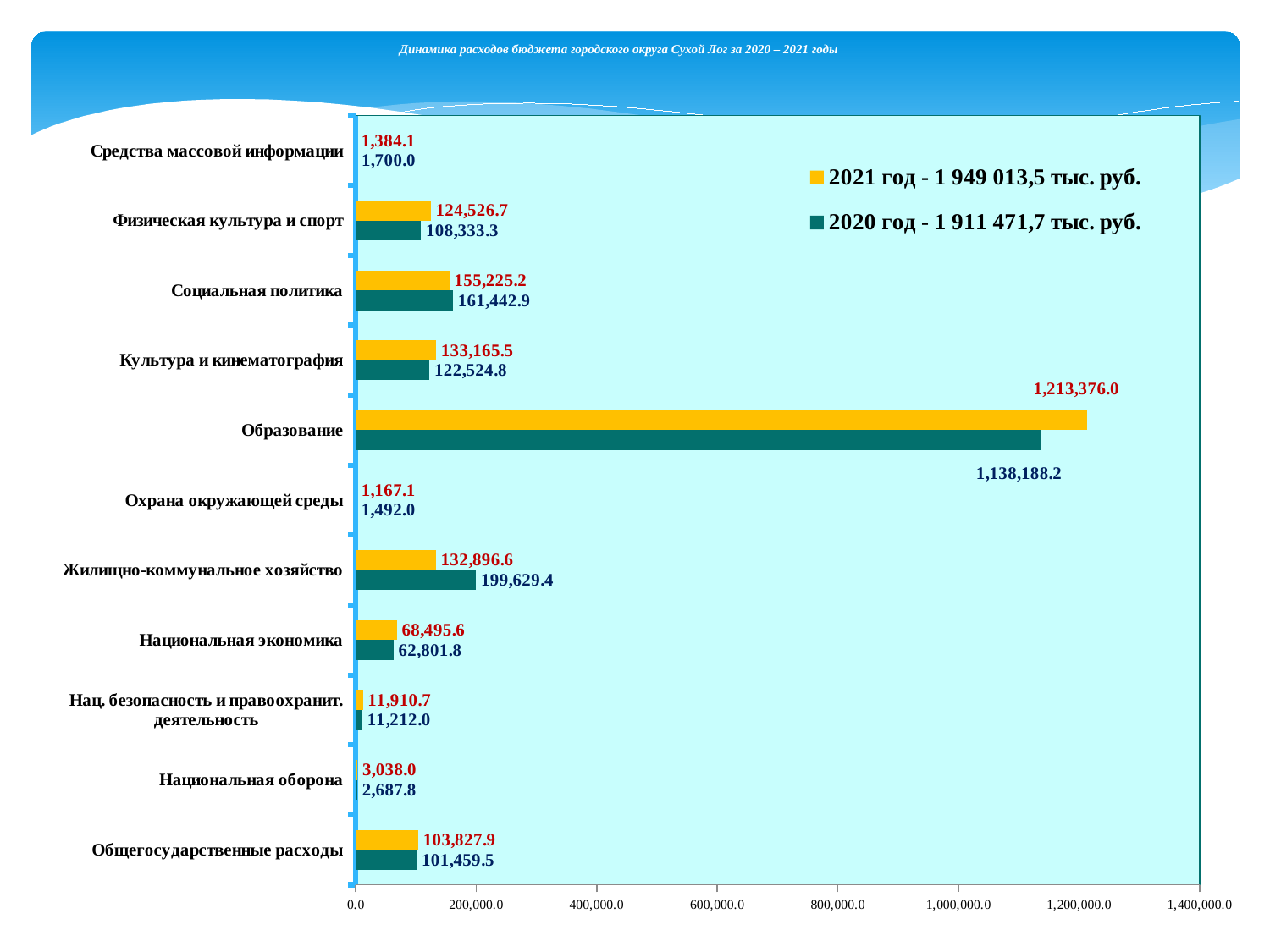
What is the 2020 value for Жилищно-коммунальное хозяйство? 199,629.4 How many expenditure categories are shown on the chart? 11 Which category has the lowest 2021 value? Охрана окружающей среды What is the difference between the 2021 and 2020 values for Образование? 75,187.8 Is the 2020 value for Образование greater or less than 1,000,000.0? greater For Жилищно-коммунальное хозяйство, which year has the larger value, 2020 or 2021? 2020 What is the 2021 value for Национальная оборона? 3,038.0 How many series does the legend list? 2 Which category has the highest 2021 value? Образование What is the 2021 value for Образование? 1,213,376.0 What total is shown in the legend entry for 2021 год? 1 949 013,5 тыс. руб. What kind of chart is shown on the slide? Bar chart